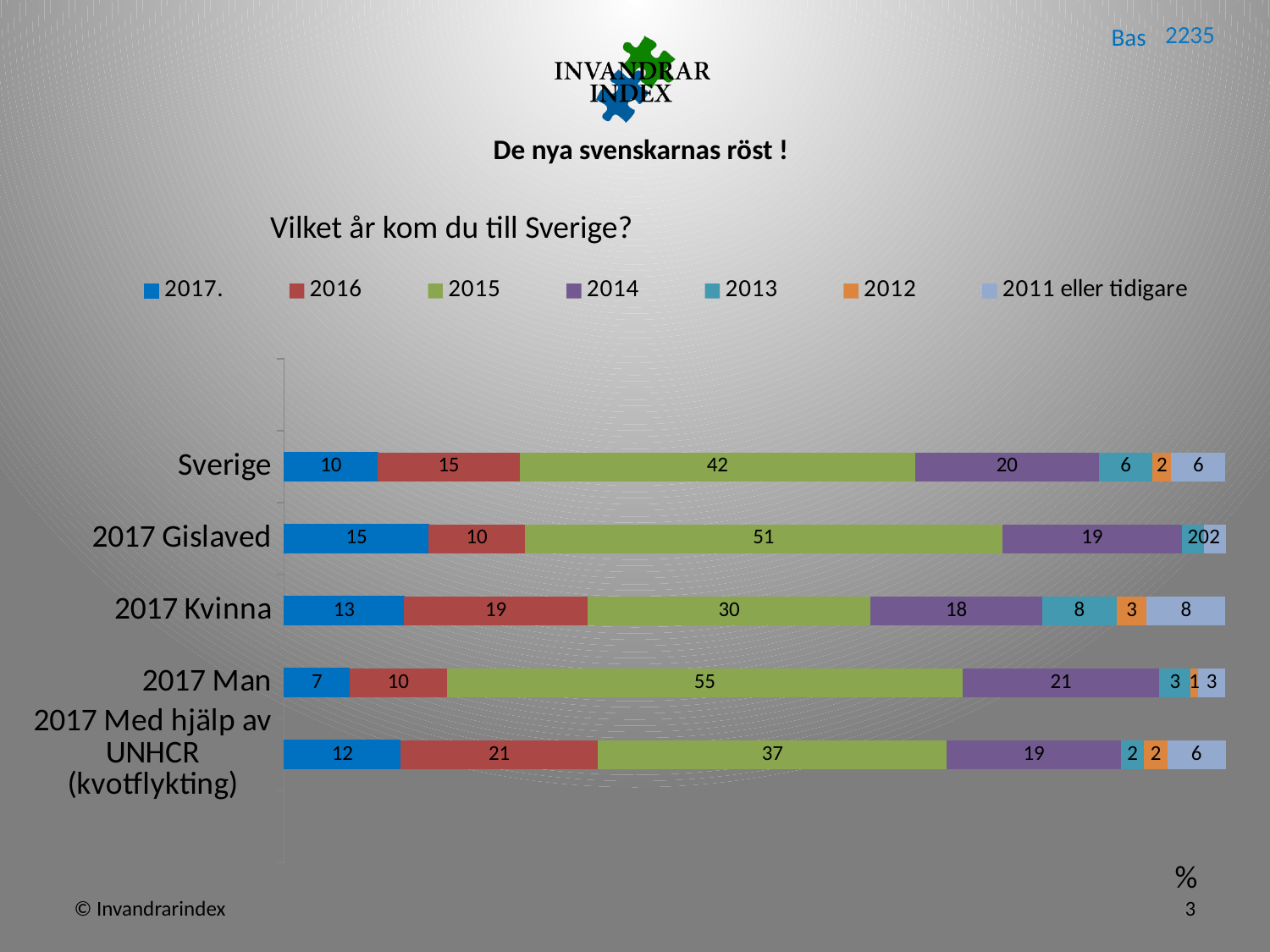
How many series does the legend list? 7 What is the value for 2016 in the 2017 Kvinna bar? 19 Which category has the highest value for 2015? 2017 Man How many categories are plotted on the chart? 5 What is the difference between the 2015 values for 2017 Man and 2017 Kvinna? 25 What is the value for 2017. in the 2017 Man bar? 7 What type of chart is shown on the slide? stacked bar chart What is the value for 2014 in the 2017 Med hjälp av UNHCR (kvotflykting) bar? 19 Which is larger: the 2016 value for 2017 Med hjälp av UNHCR (kvotflykting) or the 2016 value for Sverige? 2017 Med hjälp av UNHCR (kvotflykting) What is the title of the chart? Vilket år kom du till Sverige? Which category has the lowest value for 2017.? 2017 Man What is the value for 2015 in the Sverige bar? 42